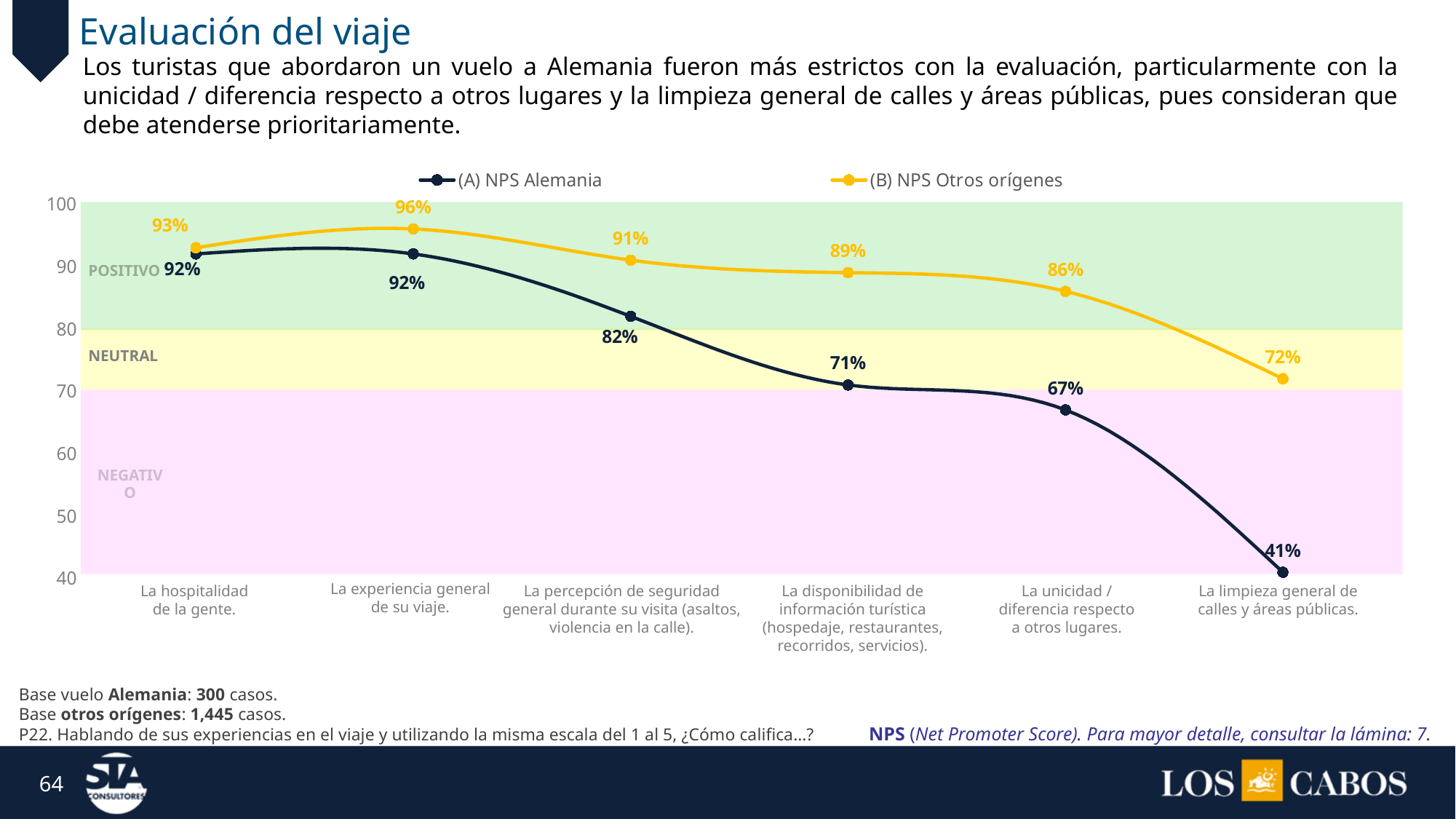
What is the (A) NPS Alemania value for 'La limpieza general de calles y áreas públicas'? 41% Which category has the highest (B) NPS Otros orígenes value? La experiencia general de su viaje. What is the difference between (B) NPS Otros orígenes and (A) NPS Alemania for 'La limpieza general de calles y áreas públicas'? 31 percentage points Does the (A) NPS Alemania series generally rise or fall from left to right across the categories? Fall How many categories are shown on the x axis? 6 How many series does the legend list? 2 What is the (B) NPS Otros orígenes value for 'La experiencia general de su viaje'? 96% What is the difference between (B) NPS Otros orígenes and (A) NPS Alemania for 'La unicidad / diferencia respecto a otros lugares'? 19 percentage points What kind of chart is shown on the slide? Line chart What is the (A) NPS Alemania value for 'La percepción de seguridad general durante su visita'? 82% For 'La disponibilidad de información turística', which series has the larger value, (A) NPS Alemania or (B) NPS Otros orígenes? (B) NPS Otros orígenes Which category has the lowest (B) NPS Otros orígenes value? La limpieza general de calles y áreas públicas.